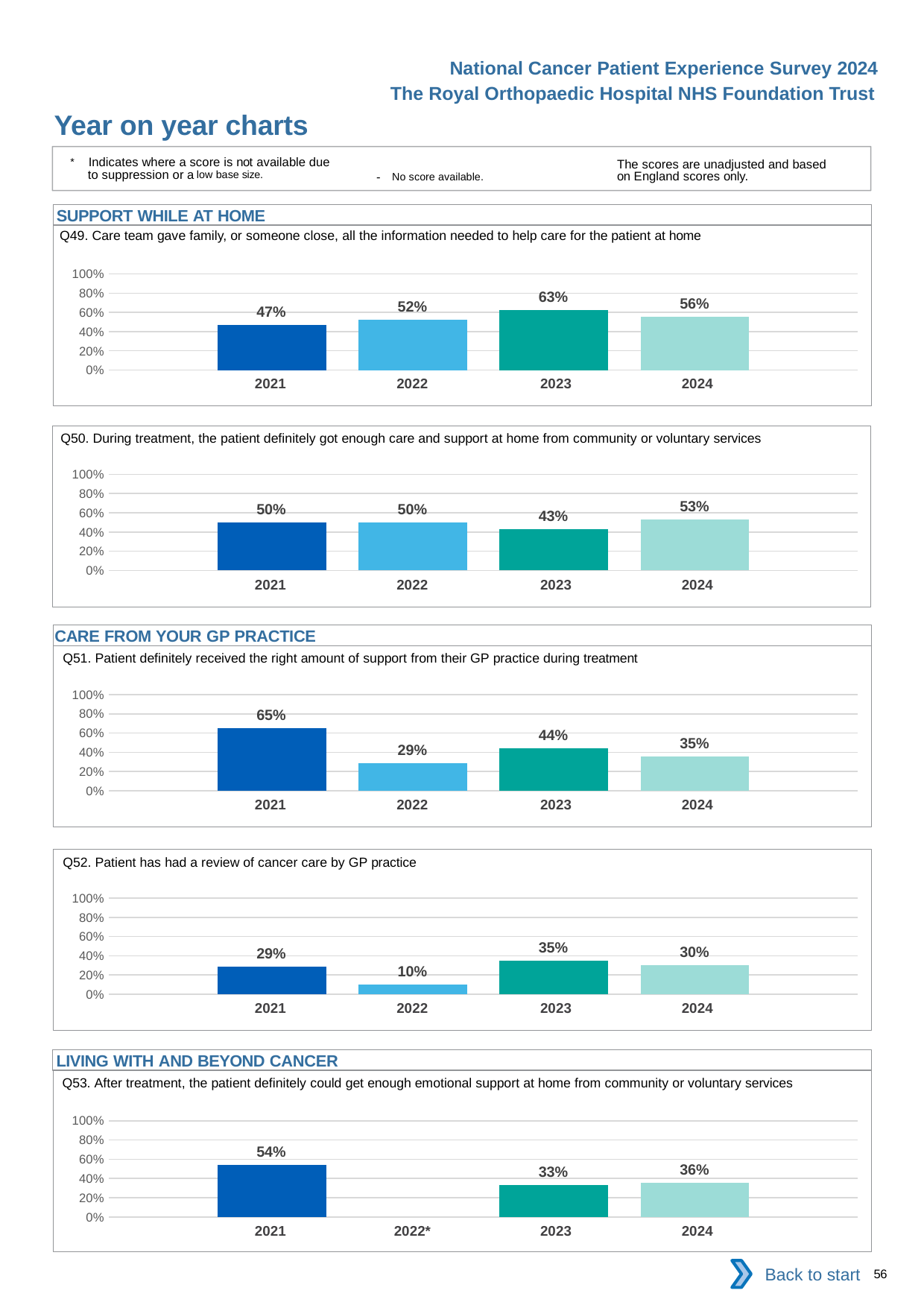
In the Q52 chart, what is the value for 2022? 10% In the Q51 chart, which is larger, the value for 2023 or the value for 2024? 2023 In the Q51 chart, what is the value for 2021? 65% In the Q53 chart, how many years have a bar plotted? 3 In the Q52 chart, what is the difference between the 2023 value and the 2021 value? 6% In the Q50 chart, which year has the highest value? 2024 In the Q53 chart, which year is marked with an asterisk indicating no score is available? 2022* In the Q49 chart, what is the value for 2023? 63% What kind of chart is the Q49 chart? Bar chart In the Q49 chart, which year has the lowest value? 2021 In the Q50 chart, what is the difference between the 2024 value and the 2023 value? 10% In the Q51 chart, is the value for 2021 greater or less than 60%? greater